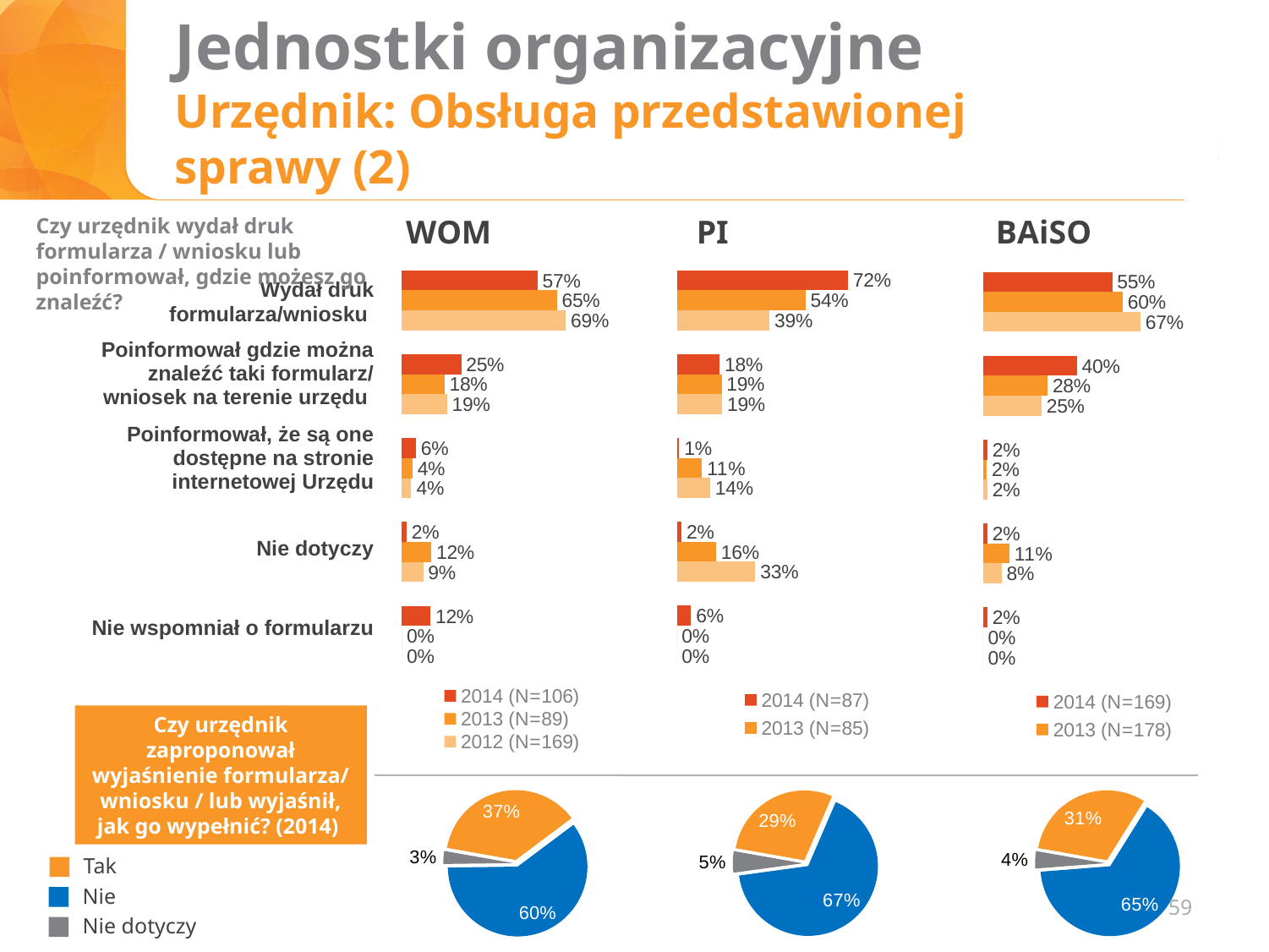
In the WOM bar chart, what is the 2014 value for 'Wydał druk formularza/wniosku'? 57% How many categories are shown in the PI bar chart? 5 In the PI pie chart, what share is 'Tak'? 29% In the WOM bar chart, which category has the highest 2014 value? Wydał druk formularza/wniosku In the BAiSO bar chart, what is the 2014 value for 'Poinformował gdzie można znaleźć taki formularz/wniosek na terenie urzędu'? 40% What type of chart is used for the BAiSO chart at the bottom right of the slide? Pie chart In the PI bar chart, what is the 2012 (lightest bar) value for 'Nie dotyczy'? 33% How many series does the legend of the WOM bar chart list? 3 In the WOM bar chart, what is the difference between the 2012 and 2014 values for 'Wydał druk formularza/wniosku'? 12% In the WOM pie chart, what share is 'Nie'? 60% In the PI bar chart, what is the 2014 value for 'Wydał druk formularza/wniosku'? 72%